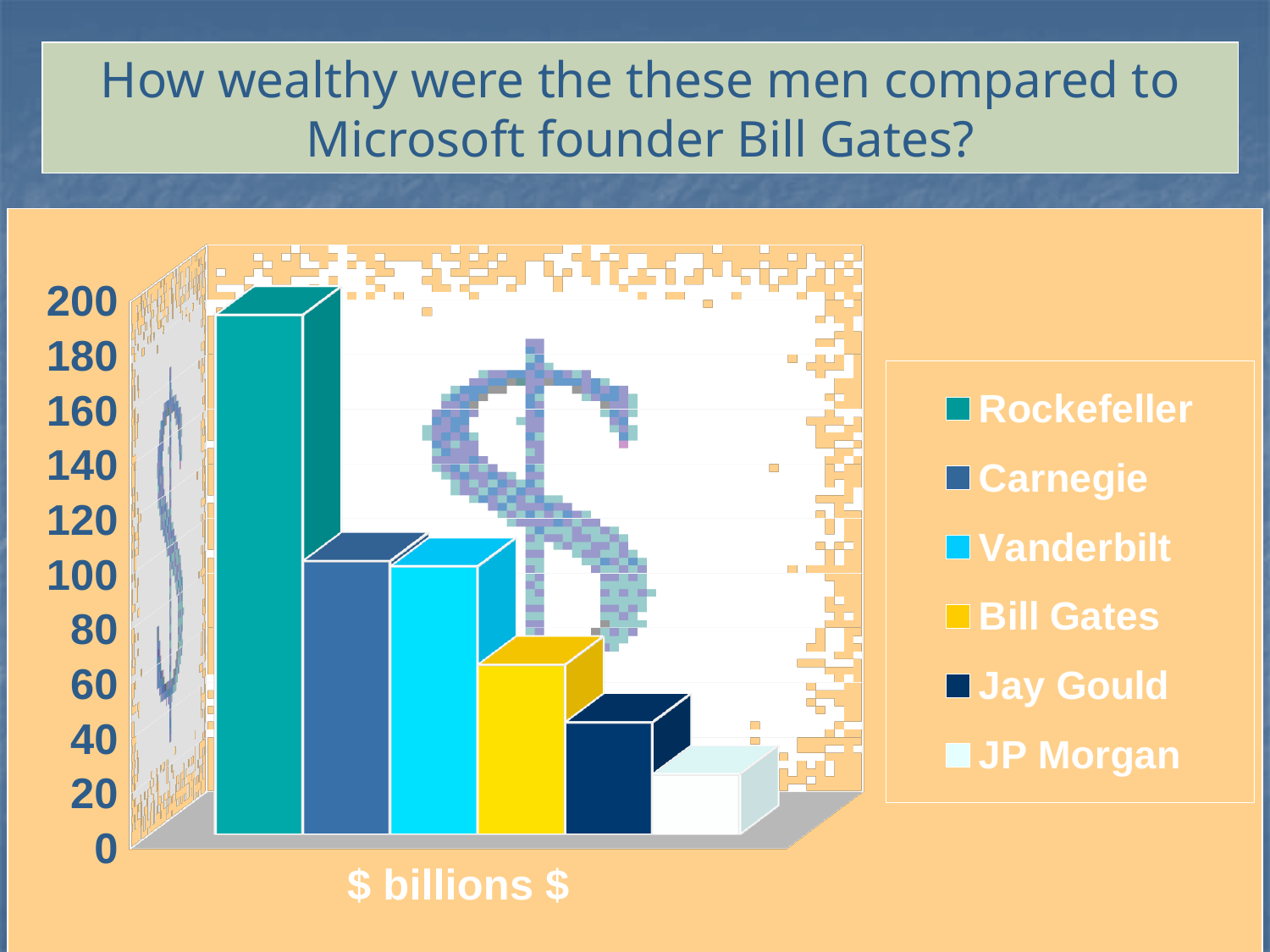
Which person has the lowest bar in the chart? JP Morgan Which is larger, the value for Bill Gates or the value for Jay Gould? Bill Gates Which person has the highest bar in the chart? Rockefeller Is the value for Bill Gates greater or less than 40? greater Is the value for JP Morgan greater or less than 60? less Is the value for Jay Gould greater or less than 80? less How many series does the legend list? 6 How many bars are plotted in the chart? 6 What label is shown beneath the chart's horizontal axis? $ billions $ What kind of chart is shown on the slide? bar chart